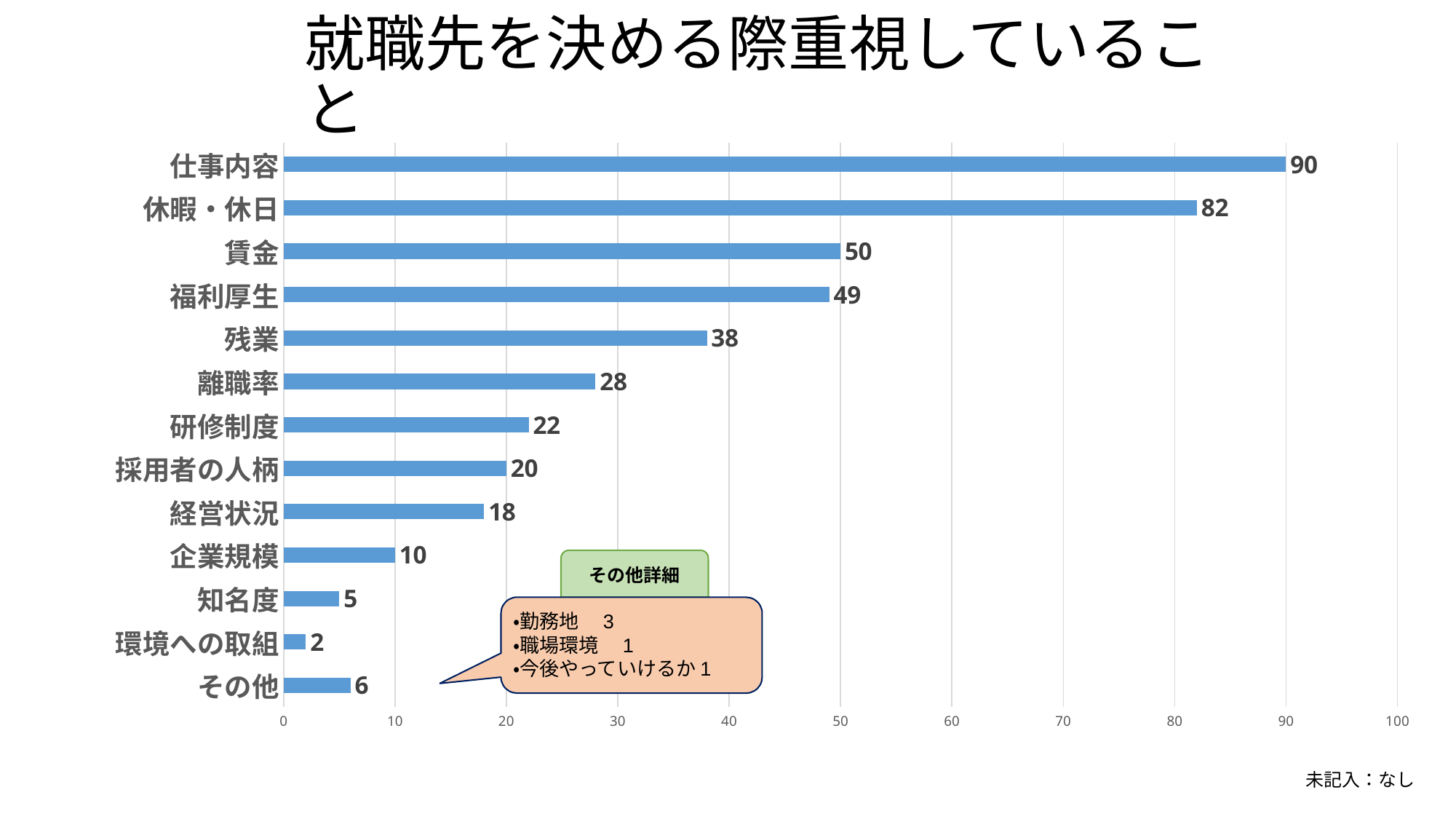
How many categories are shown in the chart? 13 What is the value for 福利厚生? 49 What kind of chart is shown on the slide? bar chart Which category has the highest value? 仕事内容 What is the value for 離職率? 28 What is the title of the chart? 就職先を決める際重視していること What is the difference between the values for 仕事内容 and 休暇・休日? 8 What is the value for 仕事内容? 90 Is the value for 残業 greater or less than 40? less Which category has the lowest value? 環境への取組 What is the difference between the values for 賃金 and 残業? 12 Which is larger, the value for 研修制度 or the value for 採用者の人柄? 研修制度